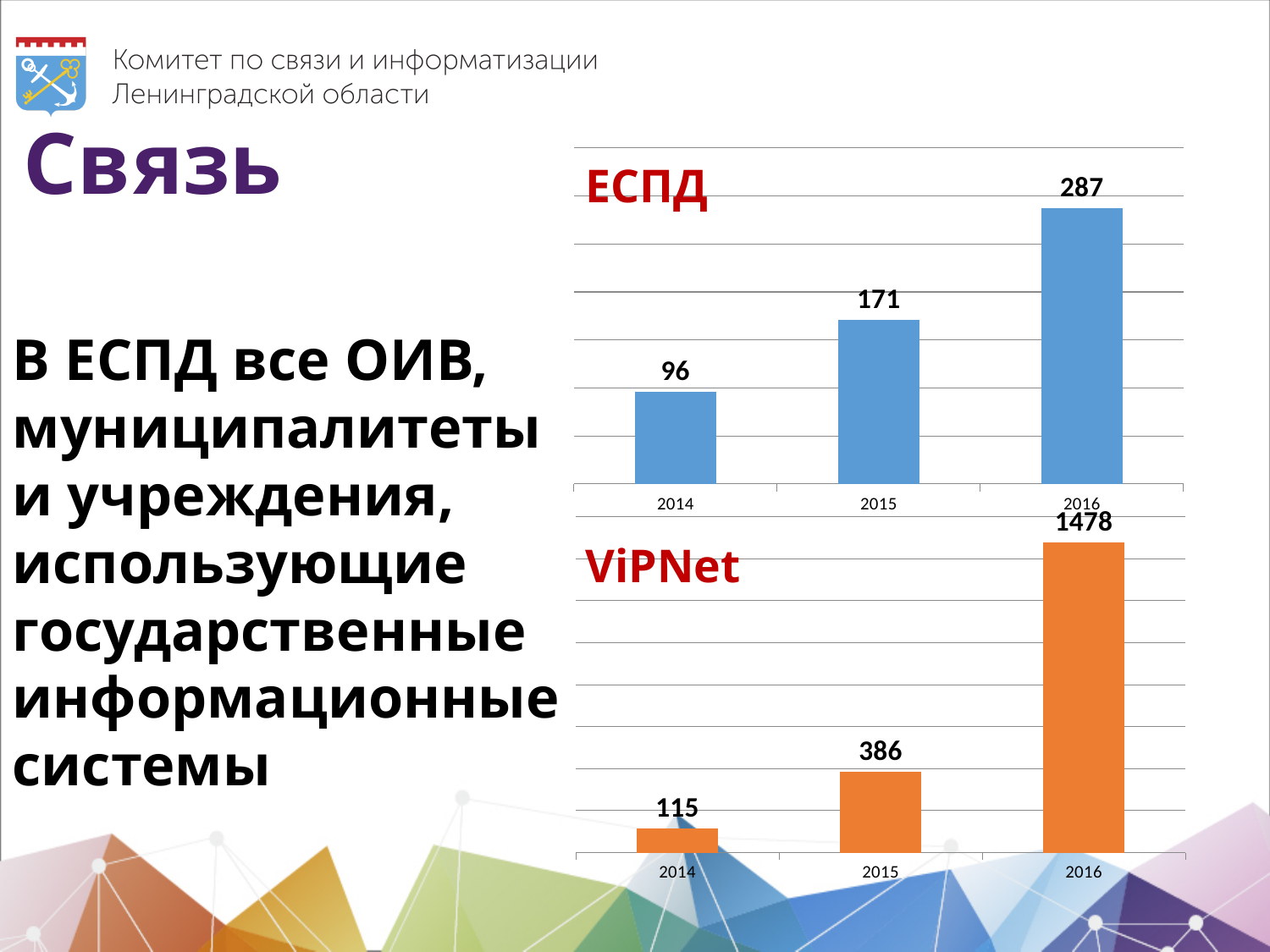
In the ЕСПД chart, what is the difference between the 2016 and 2015 values? 116 In the ViPNet chart, what is the value for 2016? 1478 In the ЕСПД chart, which year has the highest value? 2016 In the ЕСПД chart, what is the value for 2016? 287 What type of chart is the ЕСПД chart? bar chart How many years are shown in the ViPNet chart? 3 In the ЕСПД chart, what is the value for 2014? 96 Which is larger: the 2015 value in the ЕСПД chart or the 2015 value in the ViPNet chart? ViPNet In the ViPNet chart, do the values rise or fall from 2014 to 2016? rise In the ViPNet chart, which year has the lowest value? 2014 In the ViPNet chart, what is the difference between the 2016 and 2014 values? 1363 In the ViPNet chart, what is the value for 2015? 386